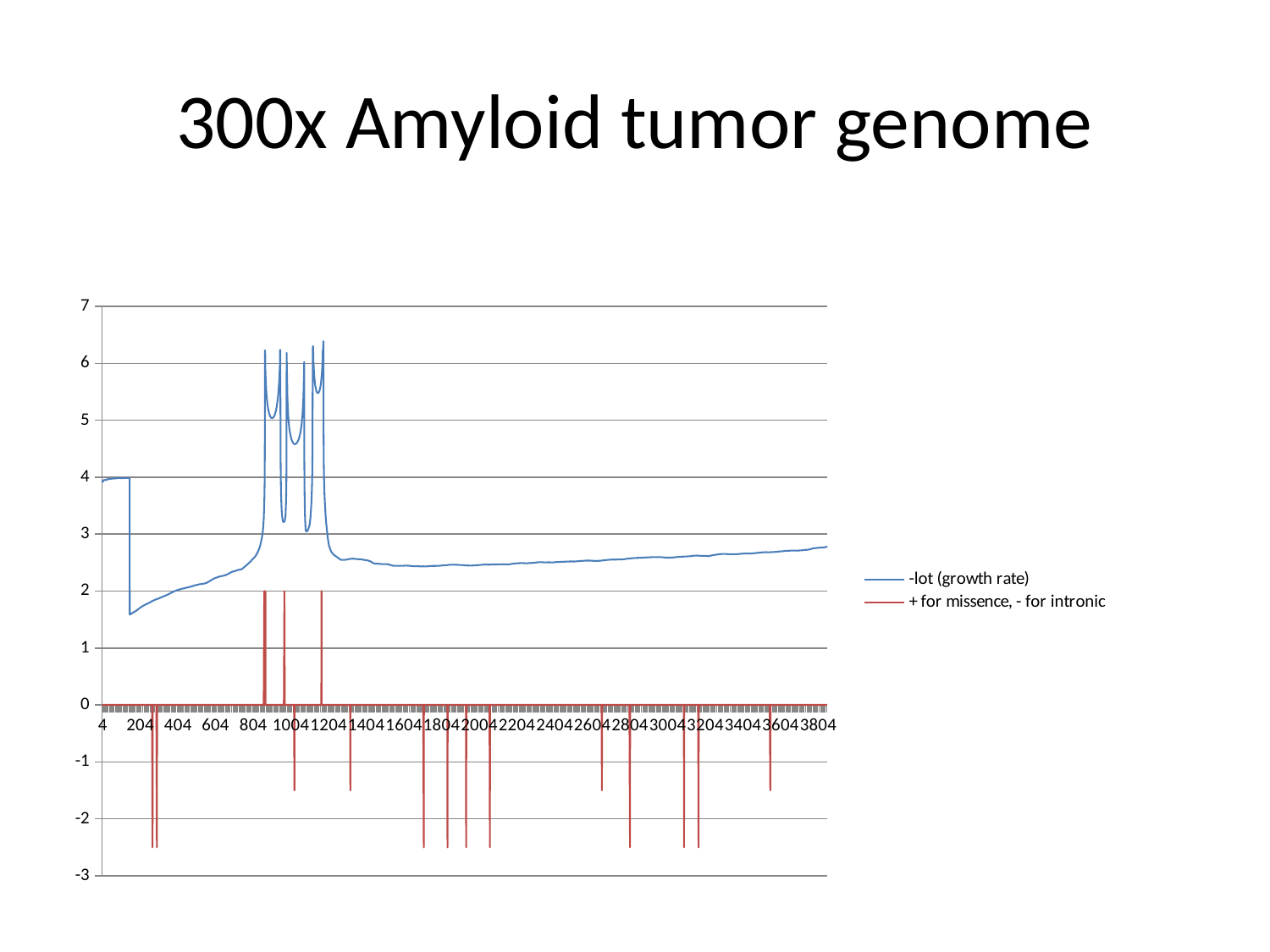
What is the title of the chart? 300x Amyloid tumor genome Are the tallest positive red spikes greater or less than 1? greater What kind of chart is shown on the slide? line chart Is the highest peak of the blue '-lot (growth rate)' line greater or less than 6? greater How many positive (upward) red spikes are plotted? 3 Is the value of the blue '-lot (growth rate)' line at x = 2004 greater or less than 3? less What is the highest value shown on the y axis? 7 How many series does the legend list? 2 Does the blue '-lot (growth rate)' line rise or fall between x = 2004 and x = 3804? rise Which series is drawn in red according to the legend? + for missence, - for intronic